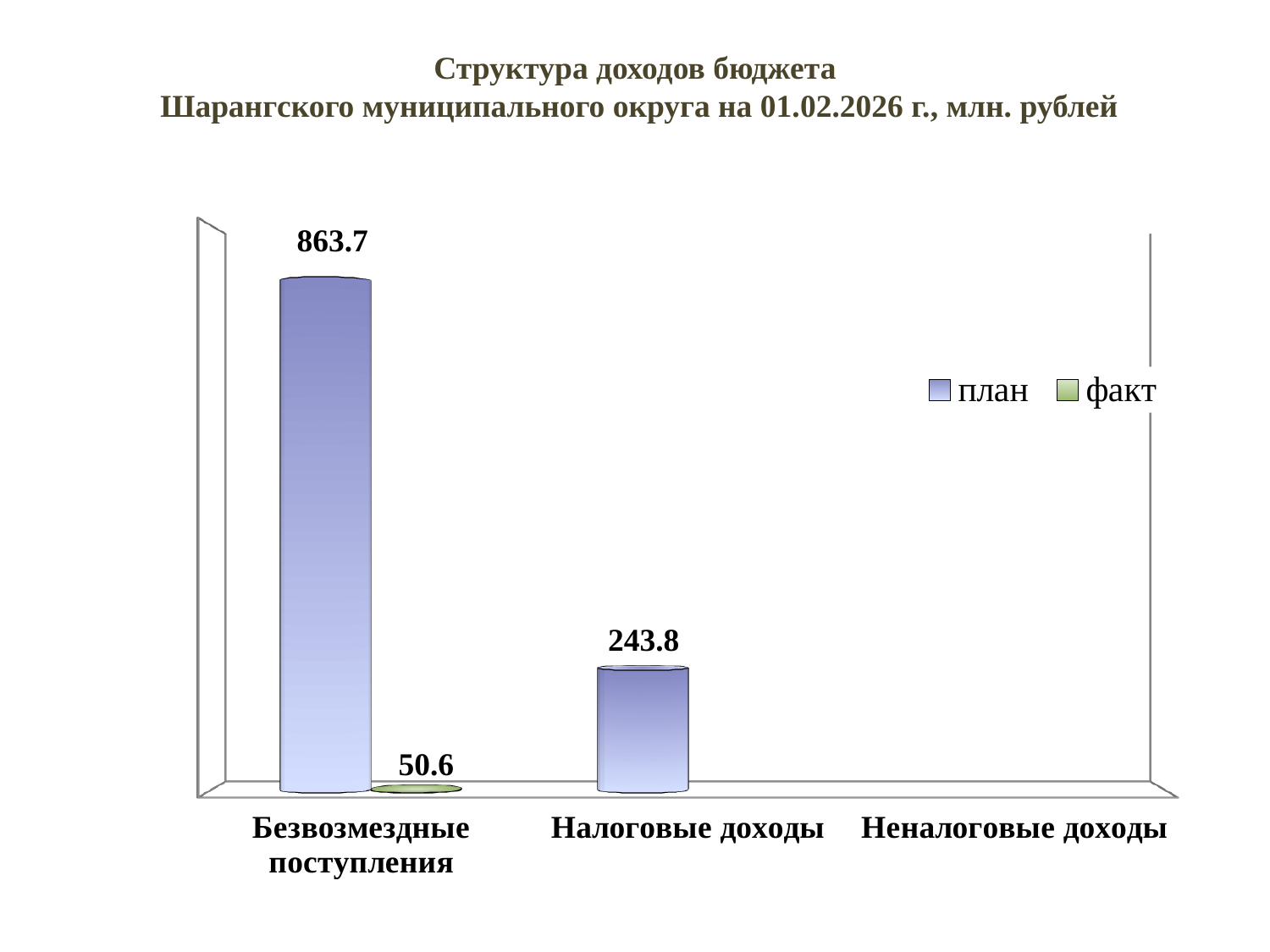
What is the difference between the план values for Безвозмездные поступления and Налоговые доходы? 619.9 What are the two series named in the legend? план and факт What is the план value for Налоговые доходы? 243.8 Which category has the highest план value? Безвозмездные поступления What kind of chart is shown on the slide? Bar chart What is the difference between the план and факт values for Безвозмездные поступления? 813.1 How many series does the legend list? 2 How many categories are shown on the x axis? 3 What is the план value for Безвозмездные поступления? 863.7 What is the факт value for Безвозмездные поступления? 50.6 In what units are the values on the chart expressed, according to the title? млн. рублей Which is larger: the план value for Налоговые доходы or the факт value for Безвозмездные поступления? план value for Налоговые доходы